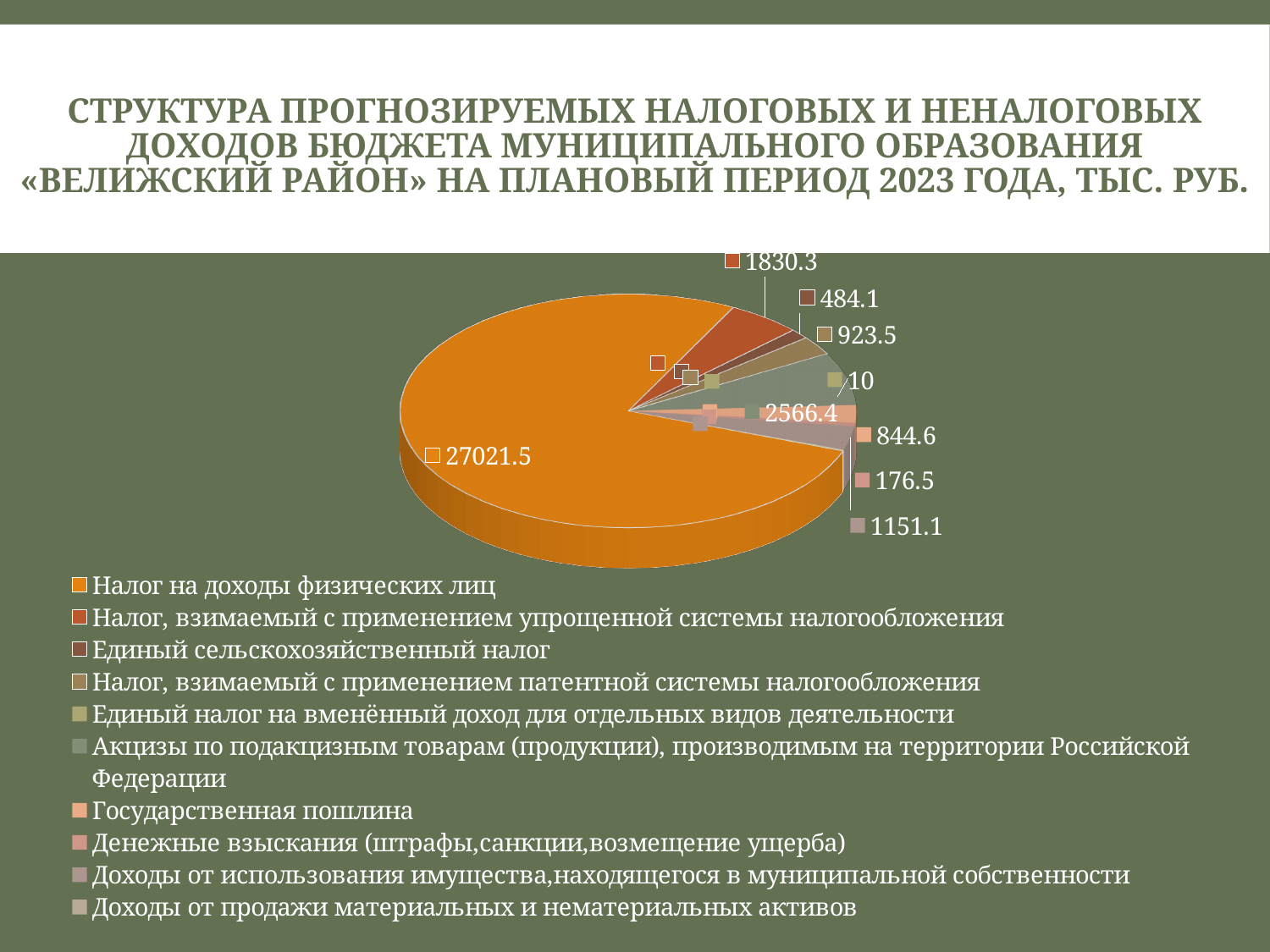
What kind of chart is shown on the slide? pie chart What value is labelled for the slice 'Государственная пошлина'? 844.6 Which is larger: the value for 'Налог, взимаемый с применением патентной системы налогообложения' (923.5) or for 'Государственная пошлина' (844.6)? Налог, взимаемый с применением патентной системы налогообложения What value is labelled for the slice 'Акцизы по подакцизным товарам (продукции), производимым на территории Российской Федерации'? 2566.4 What unit of measurement is stated in the chart title? тыс. руб. How many categories does the legend of the pie chart list? 10 What is the value shown for the largest slice of the pie chart? 27021.5 What value is labelled for the slice 'Налог, взимаемый с применением упрощенной системы налогообложения'? 1830.3 Which category has the largest slice of the pie chart? Налог на доходы физических лиц What is the smallest value labelled on the pie chart? 10 What is the difference between the values 2566.4 and 1830.3 labelled on the pie chart? 736.1 What value is labelled for the slice 'Доходы от использования имущества,находящегося в муниципальной собственности'? 1151.1